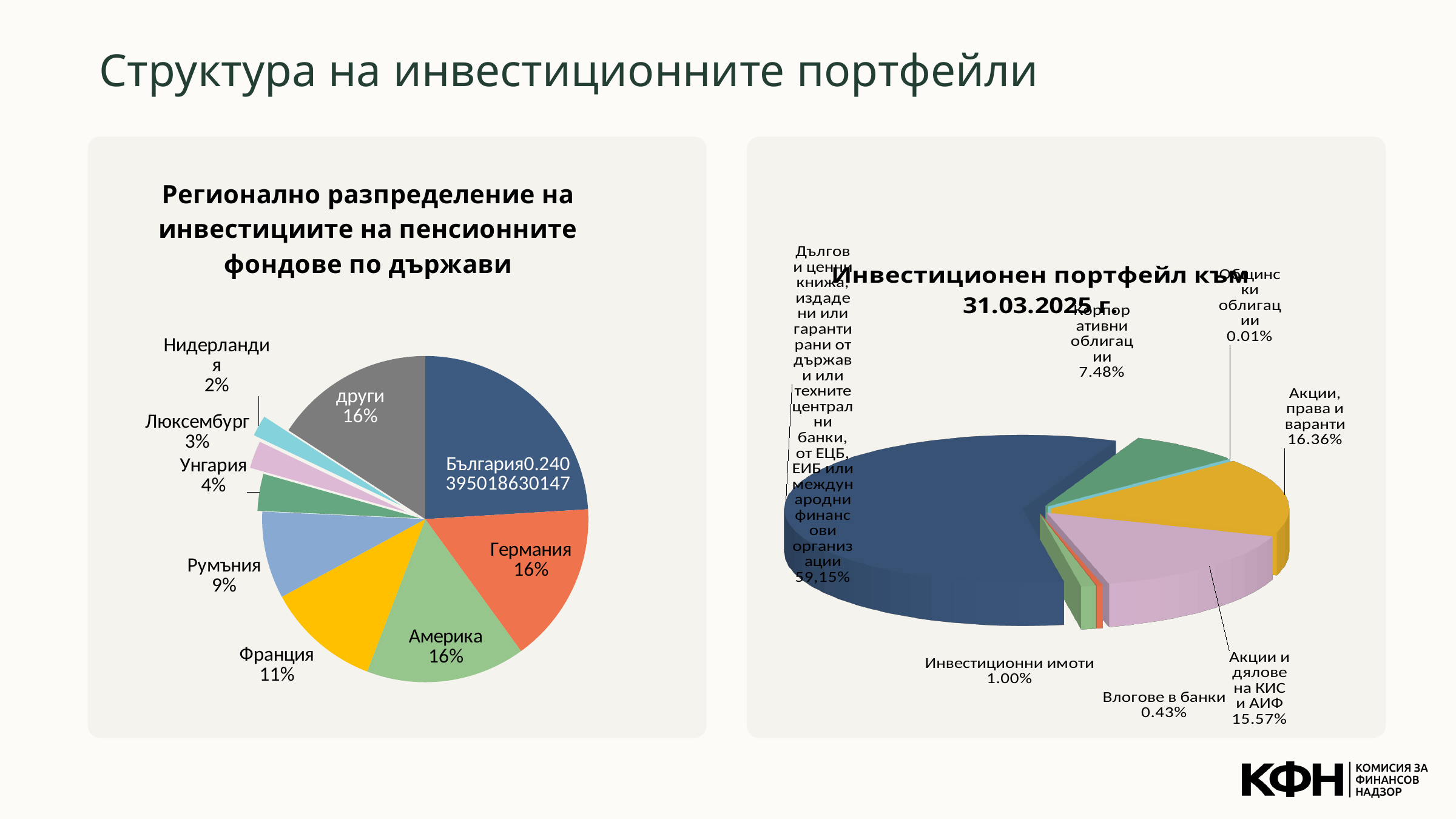
On the right chart (Инвестиционен портфейл към 31.03.2025 г.), what is the difference between the shares of Акции, права и варанти and Акции и дялове на КИС и АИФ? 0.79% On the left chart (Регионално разпределение), how many slices does the pie have? 9 On the left chart (Регионално разпределение), which is larger: Люксембург or Унгария? Унгария What type of chart is the right chart (Инвестиционен портфейл към 31.03.2025 г.)? Pie chart On the right chart (Инвестиционен портфейл към 31.03.2025 г.), what share do Корпоративни облигации have? 7.48% On the left chart (Регионално разпределение на инвестициите на пенсионните фондове по държави), what share does Германия have? 16% On the left chart (Регионално разпределение), which country has the smallest share? Нидерландия On the left chart (Регионално разпределение), which category has the largest slice? България On the left chart (Регионално разпределение), what share does Румъния have? 9% On the left chart (Регионално разпределение), what is the difference between the shares of Франция and Унгария? 7% On the right chart (Инвестиционен портфейл към 31.03.2025 г.), which category has the smallest share? Общински облигации On the left chart (Регионално разпределение), what share does Франция have? 11%